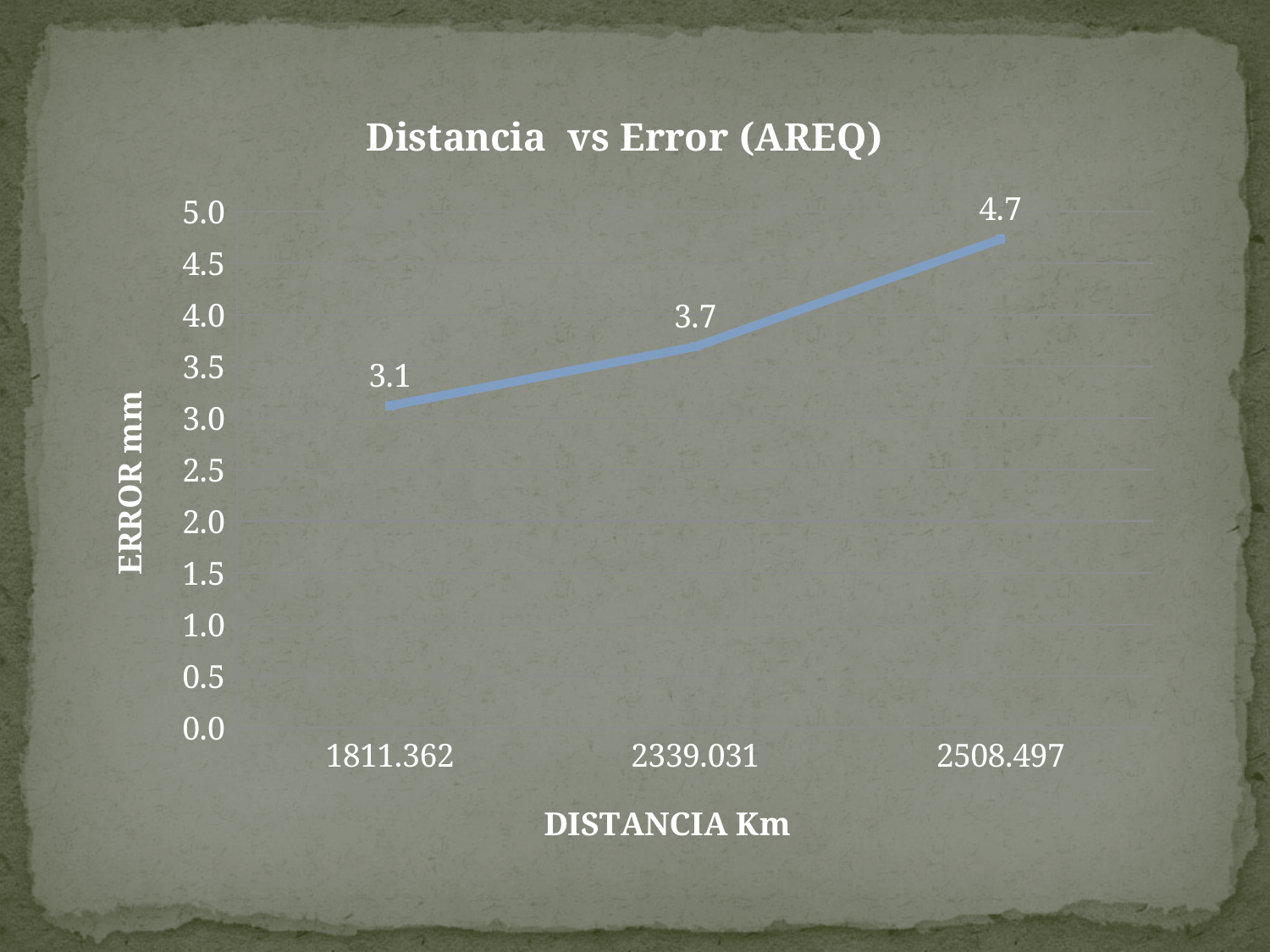
What is the difference in error between the distances 2339.031 km and 1811.362 km? 0.6 Which distance has a larger error, 2339.031 km or 2508.497 km? 2508.497 Is the error at 2508.497 km greater or less than 4.0? greater What is the error value at a distance of 2339.031 km? 3.7 What kind of chart is shown on the slide? line chart What is the error value at a distance of 1811.362 km? 3.1 At which distance is the error lowest? 1811.362 At which distance is the error highest? 2508.497 What is the difference in error between the distances 2508.497 km and 1811.362 km? 1.6 How many data points are plotted on the chart? 3 Does the error rise or fall as distance increases along the x axis? rise What is the error value at a distance of 2508.497 km? 4.7